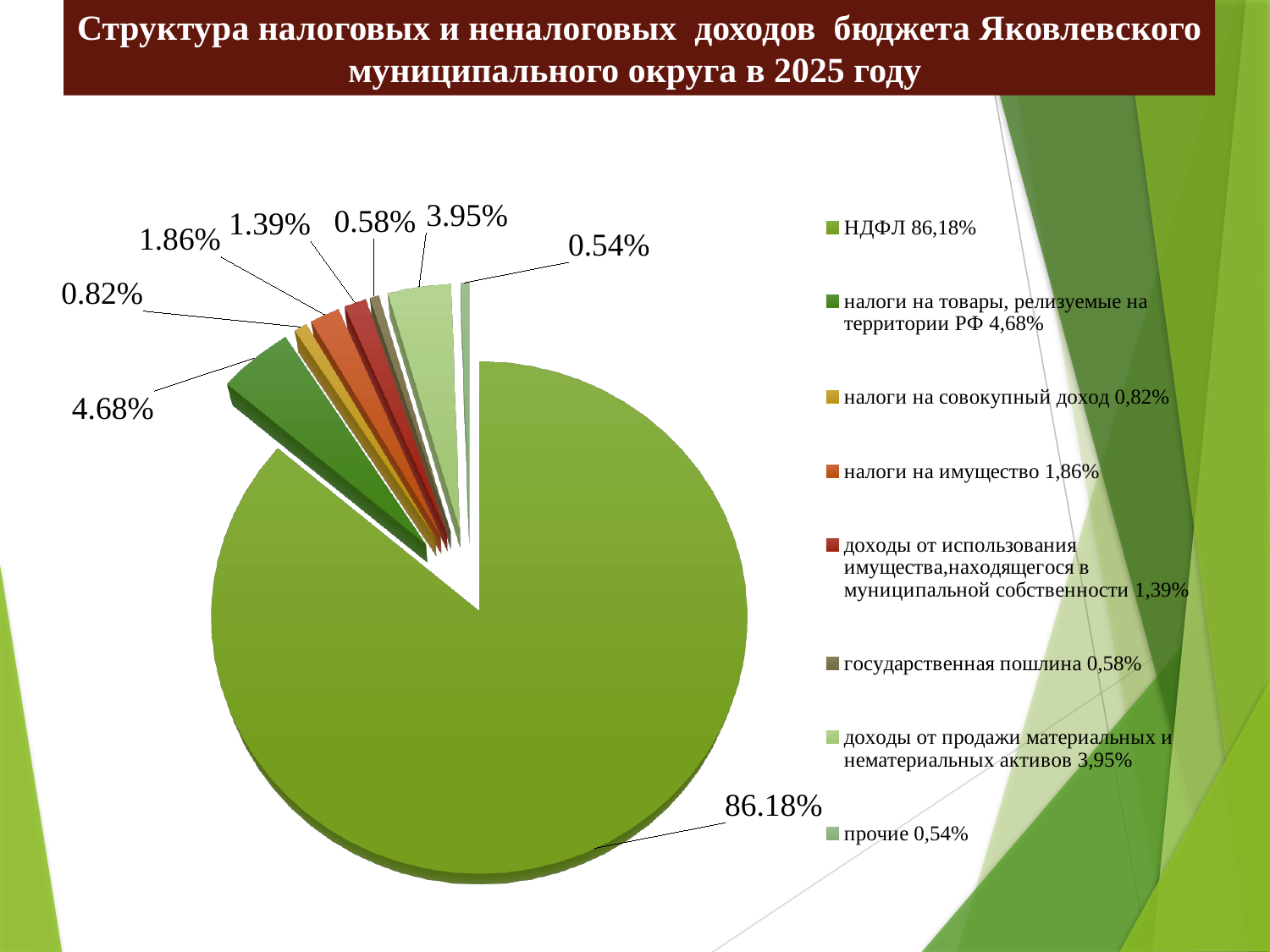
What is the difference between the shares of налоги на товары, реализуемые на территории РФ and доходы от продажи материальных и нематериальных активов? 0.73% What is the value shown for налоги на имущество? 1.86% What colour is the slice for НДФЛ? green What is the value shown for налоги на товары, реализуемые на территории РФ? 4.68% What is the value shown for государственная пошлина? 0.58% Which category has the largest slice of the pie? НДФЛ How many categories does the legend list? 8 What kind of chart is shown on the slide? pie chart Which category has the smallest slice of the pie? прочие What is the value shown for доходы от продажи материальных и нематериальных активов? 3.95% Which is larger: налоги на совокупный доход or налоги на имущество? налоги на имущество What share of the pie does НДФЛ account for? 86.18%